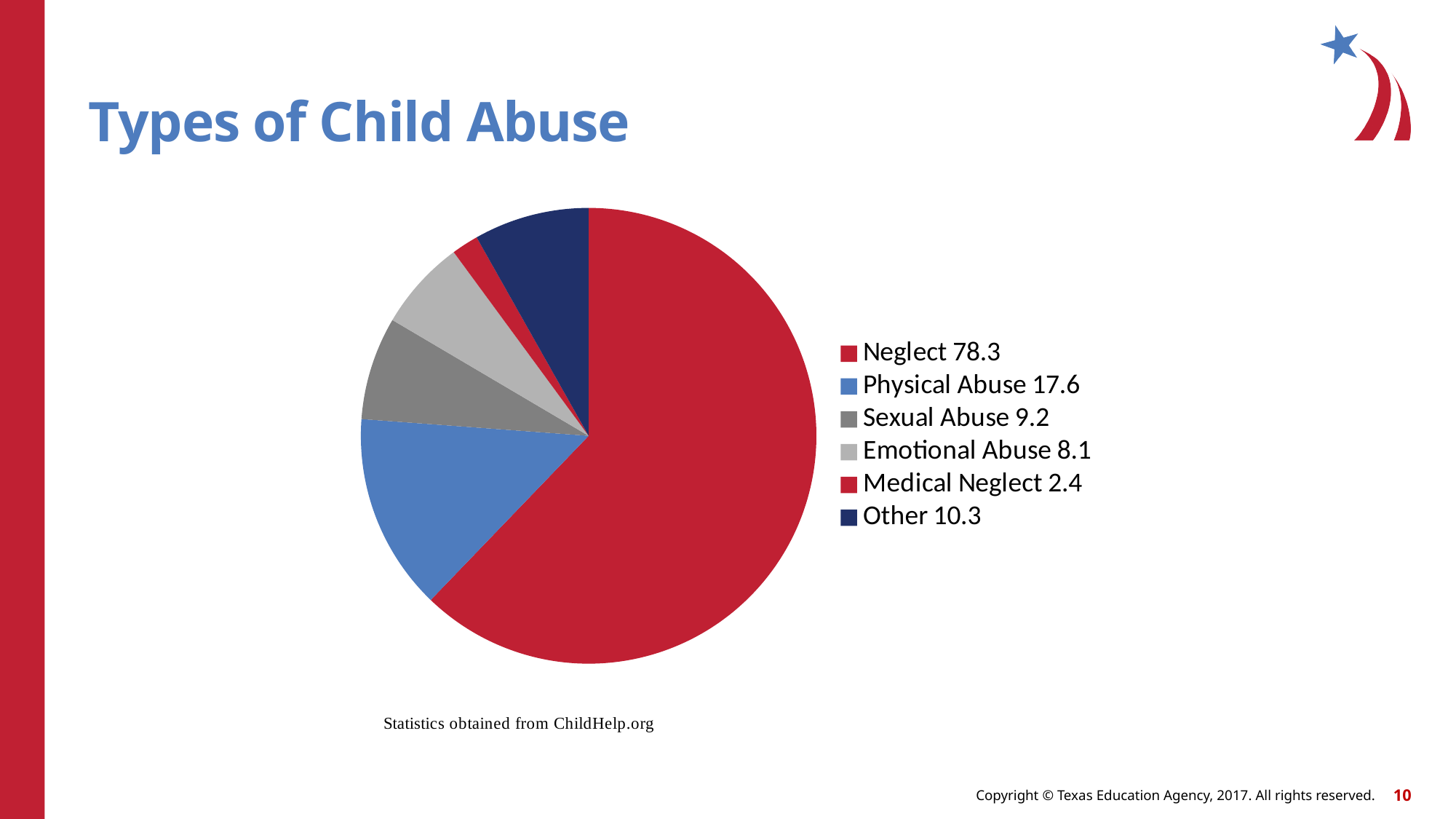
What is the difference between the values for Neglect and Physical Abuse? 60.7 What is the value shown for Neglect? 78.3 What is the value shown for Medical Neglect? 2.4 Which category has the smallest value? Medical Neglect What kind of chart is shown on the slide? Pie chart What is the value shown for Physical Abuse? 17.6 What is the value shown for Other? 10.3 What is the title of the slide containing the chart? Types of Child Abuse How many categories does the pie chart show? 6 Which category has the largest value? Neglect Which is larger, the value for Other or the value for Sexual Abuse? Other What is the difference between the values for Sexual Abuse and Emotional Abuse? 1.1